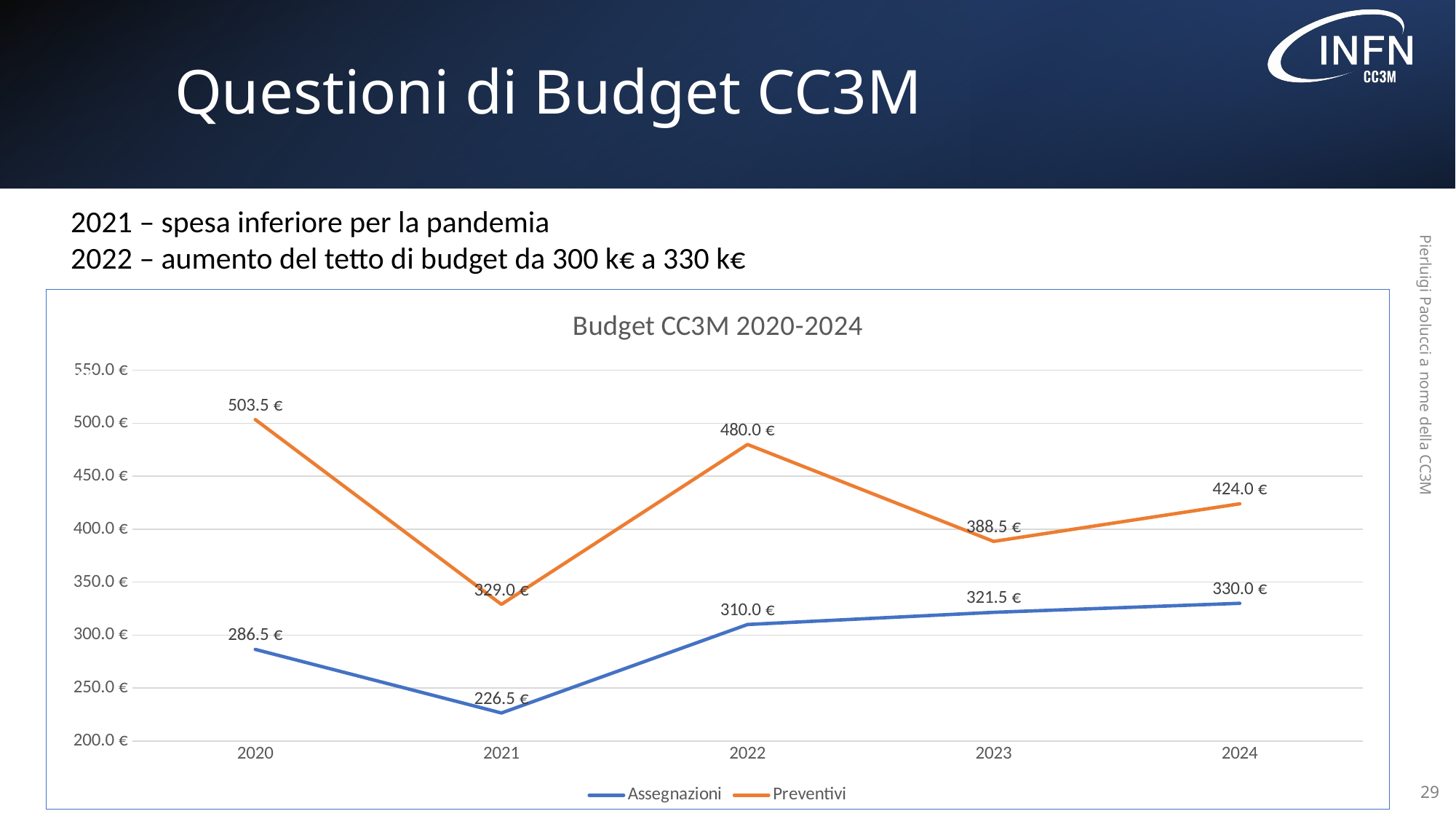
Is the value of Preventivi in 2023 greater or less than 400.0 €? less What kind of chart is this? line chart What is the value of Assegnazioni in 2021? 226.5 € What is the value of Assegnazioni in 2024? 330.0 € What is the value of Preventivi in 2020? 503.5 € In which year is Assegnazioni highest? 2024 How many years are shown on the x axis? 5 What is the title of the chart? Budget CC3M 2020-2024 In which year is Preventivi lowest? 2021 Which is larger in 2023, Preventivi or Assegnazioni? Preventivi How many series does the legend list? 2 What is the difference between Preventivi and Assegnazioni in 2022? 170.0 €